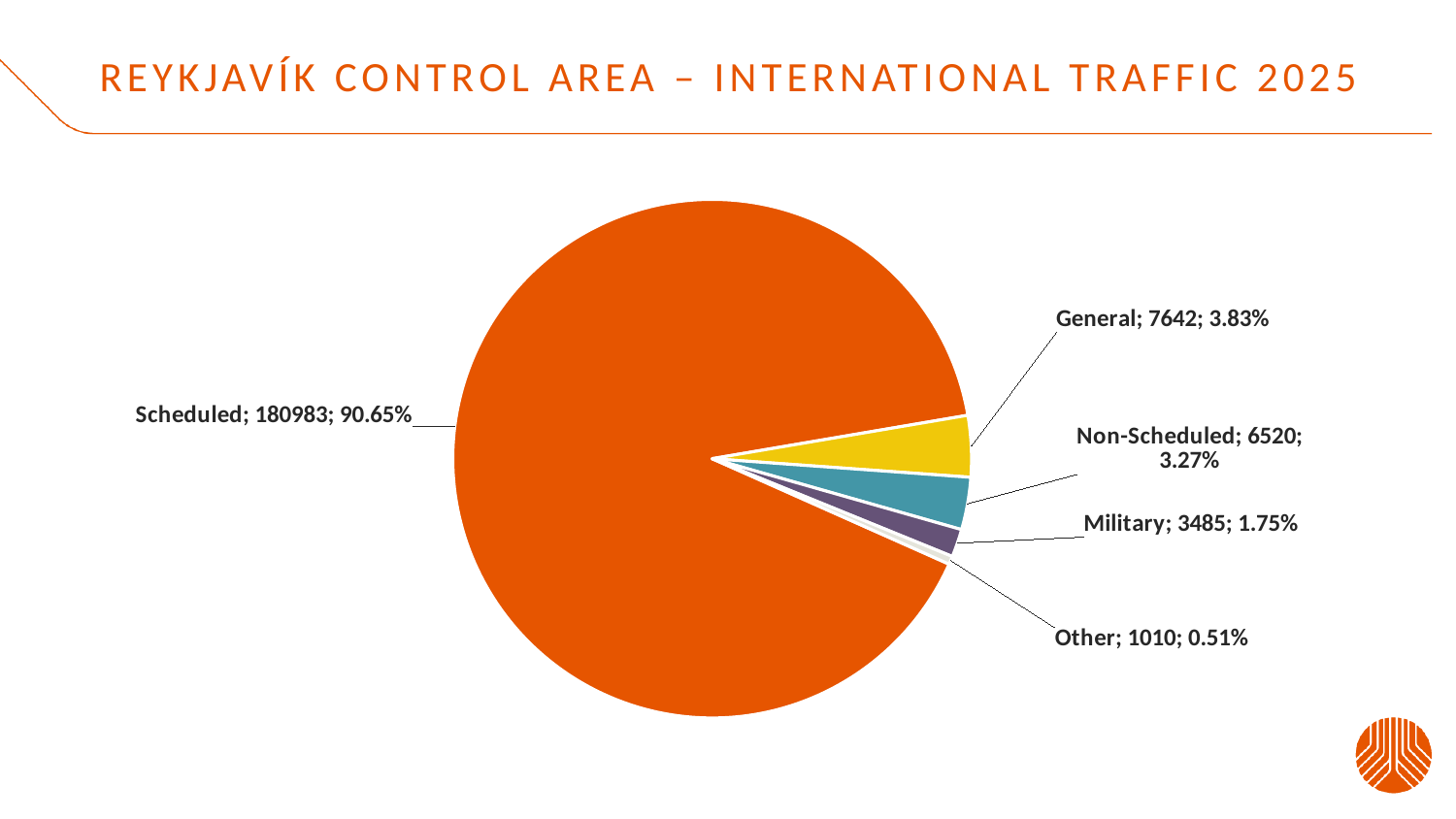
What is the value for Military traffic? 3485 What is the value for Scheduled traffic? 180983 What is the title of the slide? Reykjavík Control Area – International Traffic 2025 What share of the pie does Other traffic represent? 0.51% How many slices does the pie chart have? 5 What is the value for General traffic? 7642 What is the difference between the General and Non-Scheduled values? 1122 Which category has the largest slice? Scheduled What share of the pie does Non-Scheduled traffic represent? 3.27% What kind of chart is shown on the slide? pie chart Which is larger, General or Non-Scheduled? General Which category has the smallest slice? Other